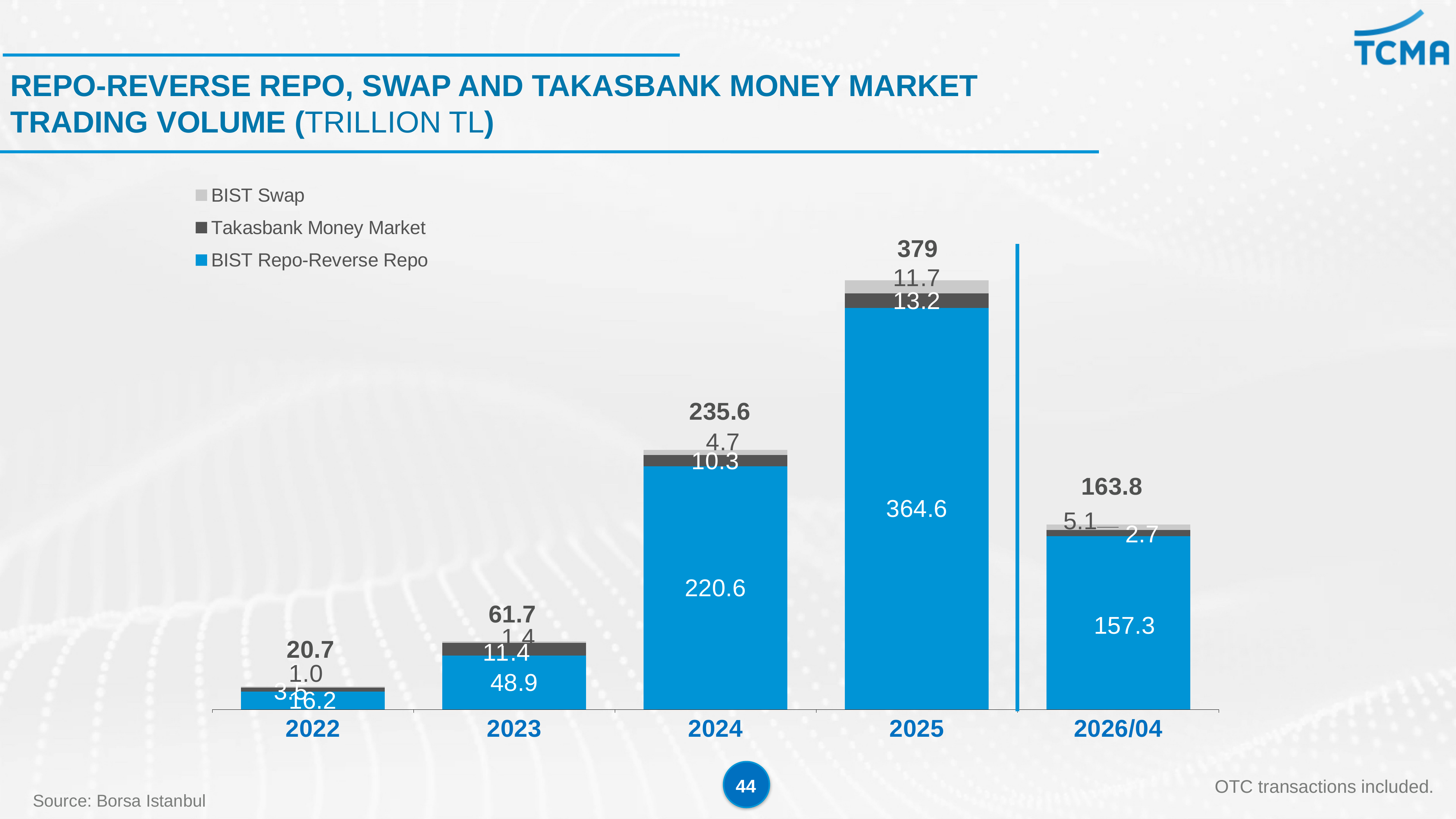
What is the difference between the BIST Repo-Reverse Repo volume in 2025 and in 2024? 144 Which year has the highest total trading volume? 2025 What kind of chart is shown on the slide? Stacked bar chart What is the BIST Repo-Reverse Repo trading volume for 2025? 364.6 What is the BIST Repo-Reverse Repo trading volume for 2026/04? 157.3 What is the total trading volume shown for 2025? 379 Which is larger, the Takasbank Money Market volume in 2024 or in 2025? 2025 What is the BIST Swap trading volume for 2024? 4.7 Which year has the lowest total trading volume? 2022 What is the total trading volume shown for 2022? 20.7 What is the Takasbank Money Market trading volume for 2023? 11.4 How many series does the legend list? 3